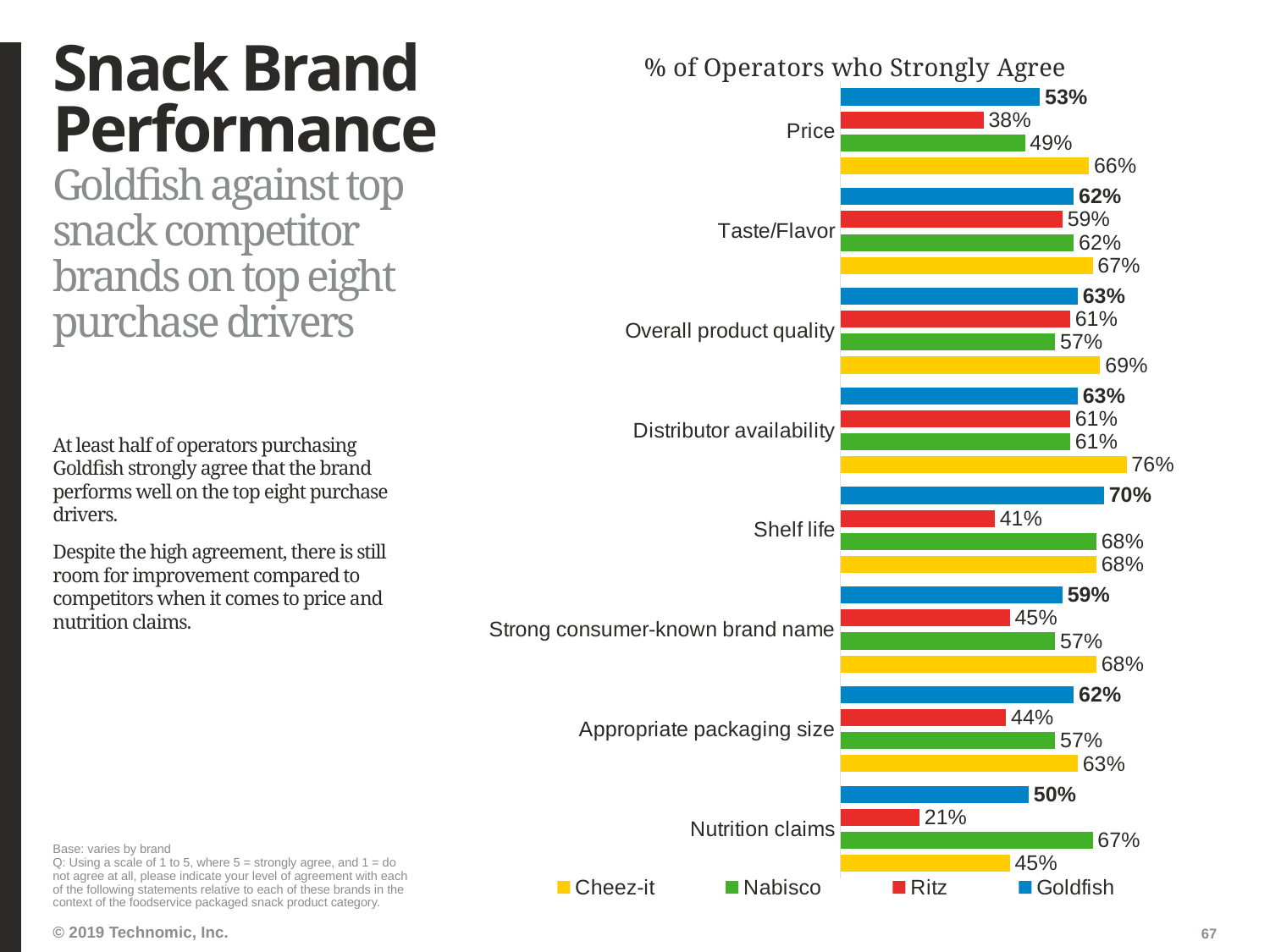
On which purchase driver does Goldfish have its highest value? Shelf life What percentage of operators strongly agree that Goldfish performs well on Price? 53% How many brands does the legend list? 4 On which purchase driver does Ritz have its lowest value? Nutrition claims What type of chart is shown on the slide? Bar chart What is the difference between Cheez-it and Goldfish on Price? 13% What is the value for Cheez-it on Distributor availability? 76% What is the value for Nabisco on Shelf life? 68% Which brand has the higher value on Nutrition claims, Nabisco or Goldfish? Nabisco What is the title of the chart? % of Operators who Strongly Agree How many purchase drivers (categories) are shown in the chart? 8 What is the value for Ritz on Nutrition claims? 21%